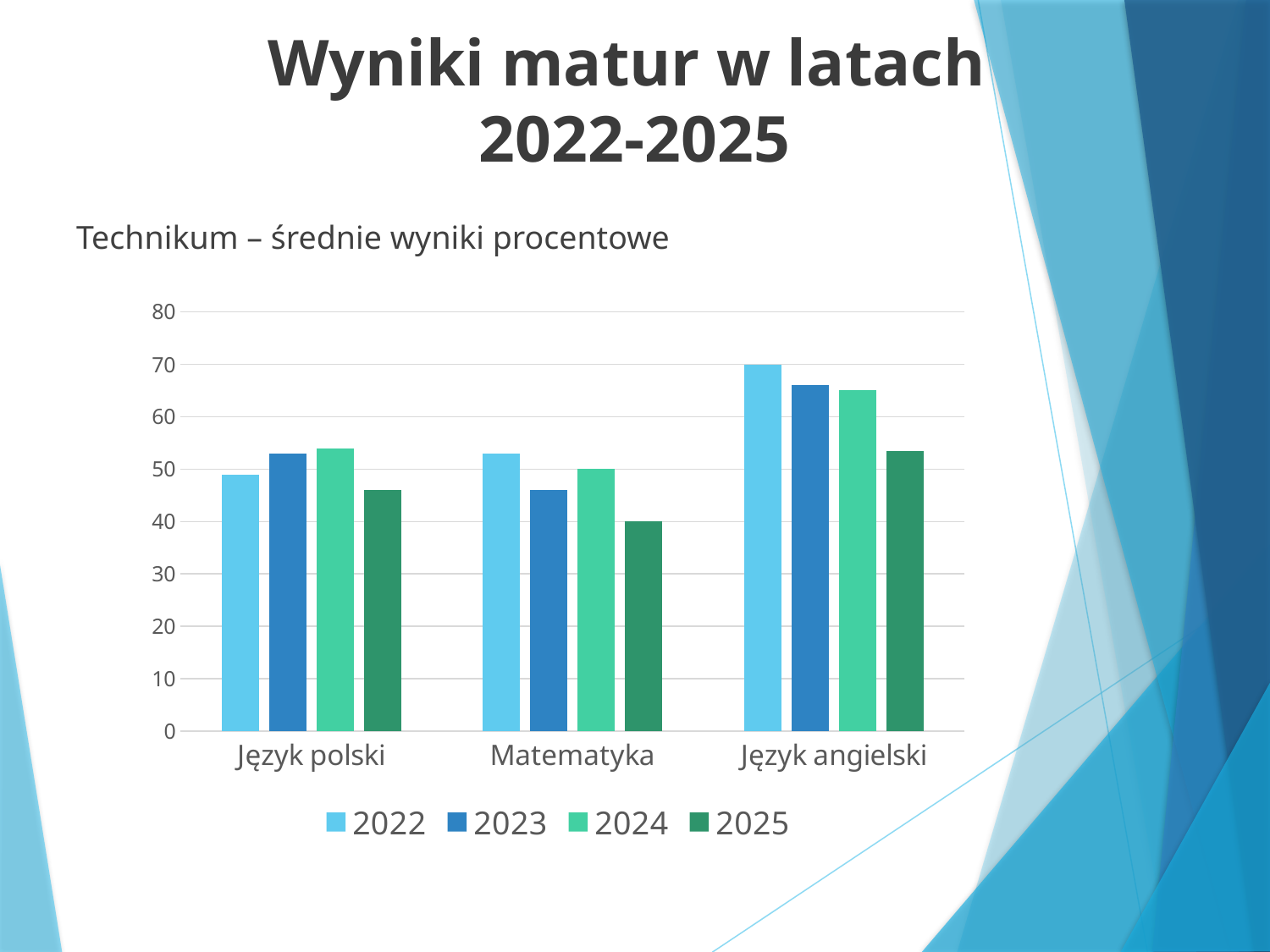
For 2022, which is larger: the value for Matematyka or the value for Język polski? Matematyka Is the 2023 value for Matematyka greater or less than 50? less What kind of chart is shown on the slide? Bar chart How many series does the legend list? 4 Do the values for Język angielski rise or fall from 2022 to 2025? fall How many subject categories are shown on the x axis? 3 For Język polski, which is larger: the 2023 value or the 2025 value? 2023 Which years are listed in the legend? 2022, 2023, 2024, 2025 Which subject has the lowest result for 2025? Matematyka Which subject has the highest result for 2022? Język angielski Is the 2023 value for Język angielski greater or less than 60? greater What is the subtitle text above the chart? Technikum – średnie wyniki procentowe